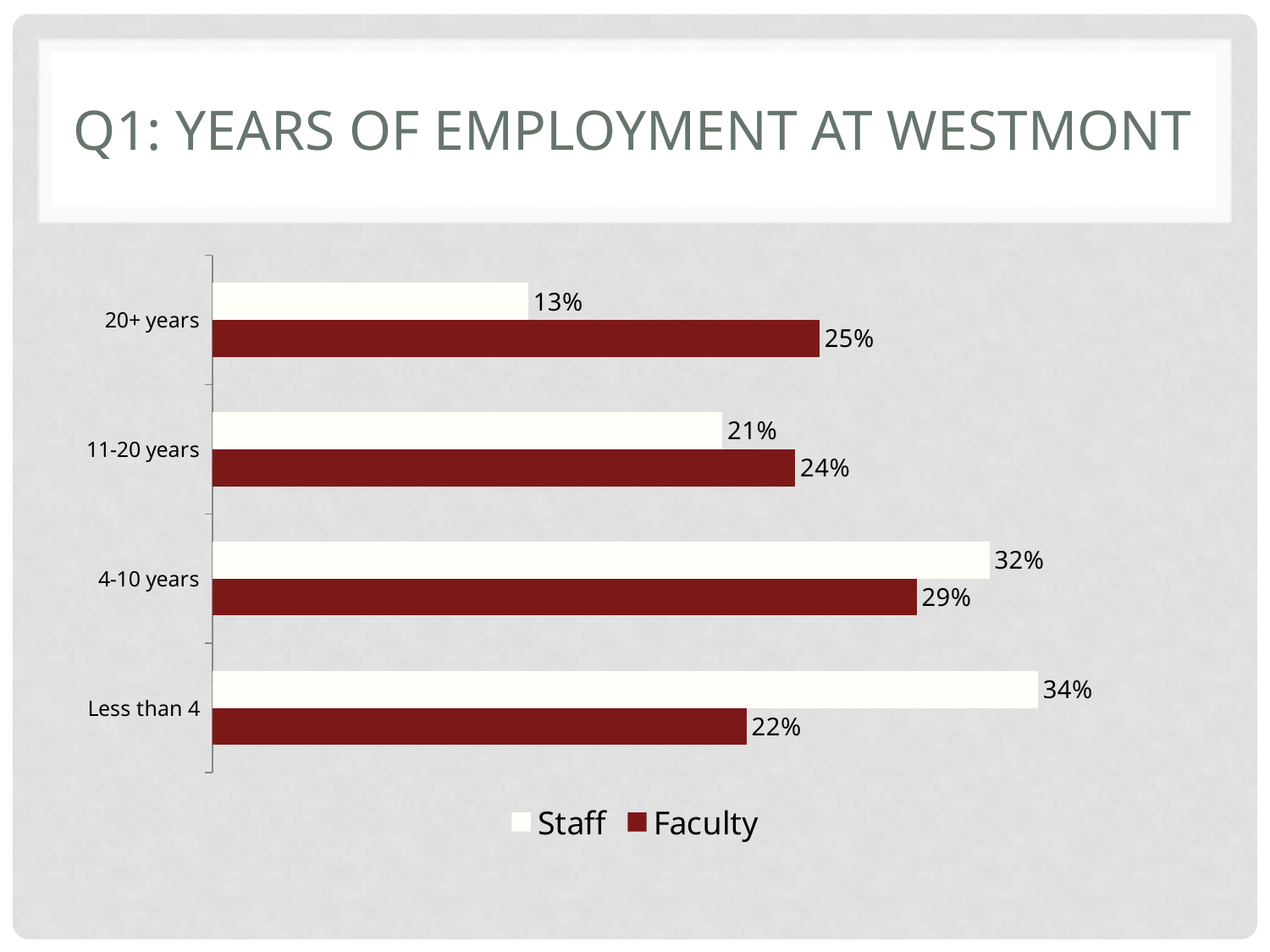
Which category has the highest Staff percentage? Less than 4 What is the Faculty value for the 11-20 years category? 24% What percentage of Faculty have been employed at Westmont for 20+ years? 25% What colour are the Faculty bars? Dark red Which category has the highest Faculty percentage? 4-10 years What kind of chart is shown on the slide? Bar chart How many series does the legend list? 2 Which is larger for the 20+ years category, the Staff value or the Faculty value? Faculty What is the difference between the Staff and Faculty values for the Less than 4 category? 12% Which category has the lowest Staff percentage? 20+ years What percentage of Staff have been employed at Westmont for less than 4 years? 34% How many employment-length categories are shown on the chart? 4